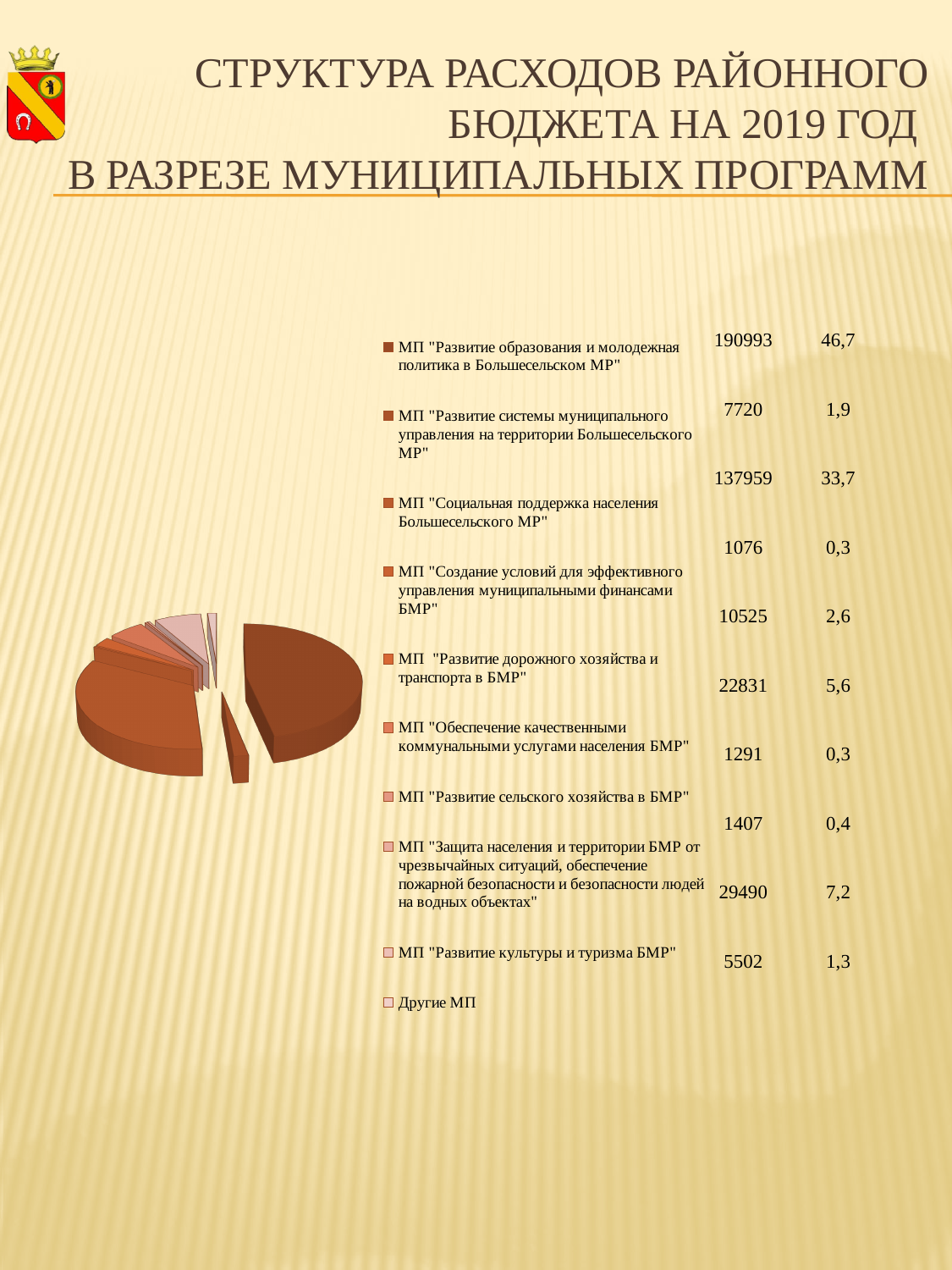
What is the percentage share of МП "Развитие сельского хозяйства в БМР"? 0,3 What is the expenditure amount for МП "Социальная поддержка населения Большесельского МР"? 137959 What is the expenditure amount for МП "Обеспечение качественными коммунальными услугами населения БМР"? 22831 Which has a larger expenditure amount: МП "Развитие дорожного хозяйства и транспорта в БМР" or МП "Развитие системы муниципального управления на территории Большесельского МР"? МП "Развитие дорожного хозяйства и транспорта в БМР" What percentage share does МП "Развитие образования и молодежная политика в Большесельском МР" have? 46,7 Which program has the largest share of the district budget expenditures? МП "Развитие образования и молодежная политика в Большесельском МР" How many categories does the legend of the pie chart list? 10 What kind of chart is shown on the slide? pie chart What percentage share does МП "Развитие культуры и туризма БМР" have? 7,2 What is the difference in expenditure amount between МП "Развитие образования и молодежная политика в Большесельском МР" and МП "Социальная поддержка населения Большесельского МР"? 53034 What is the expenditure amount for Другие МП? 5502 Which program has the smallest amount of expenditures? МП "Создание условий для эффективного управления муниципальными финансами БМР"